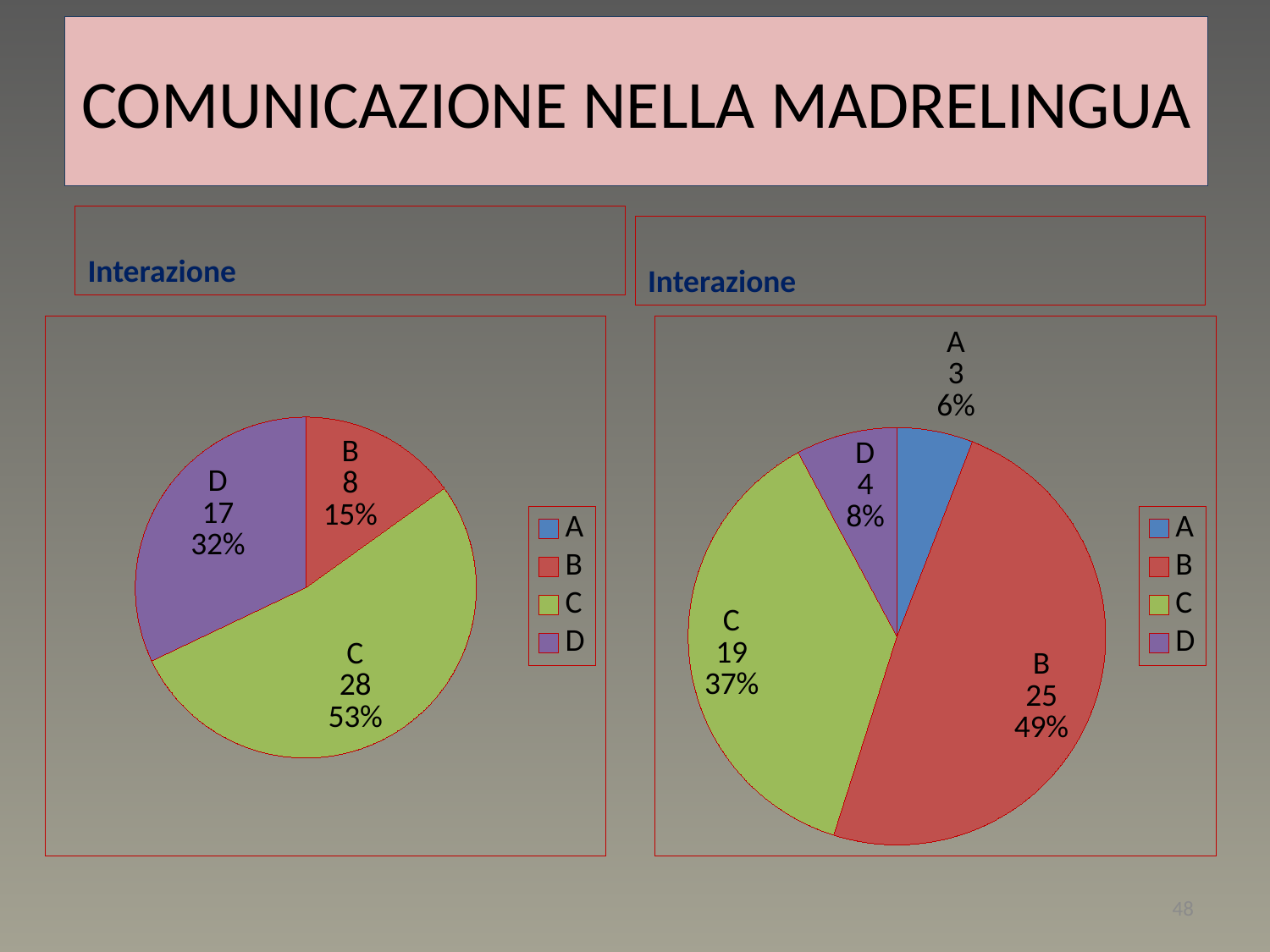
In the right pie chart, what percentage share does category A have? 6% What type of chart is shown on the left side of the slide? Pie chart In the left pie chart, which category has the largest slice? C In the right pie chart, which category has the smallest slice? A In the left pie chart, what is the difference between the values for C and B? 20 In the left pie chart, what is the value for category C? 28 In the right pie chart, what is the difference between the values for B and C? 6 In the right pie chart, which is larger, the value for C or the value for D? C In the left pie chart, what percentage share does category D have? 32% In the right pie chart, what is the value for category B? 25 What is the title shown above the right pie chart? Interazione How many entries does the legend of the right pie chart list? 4